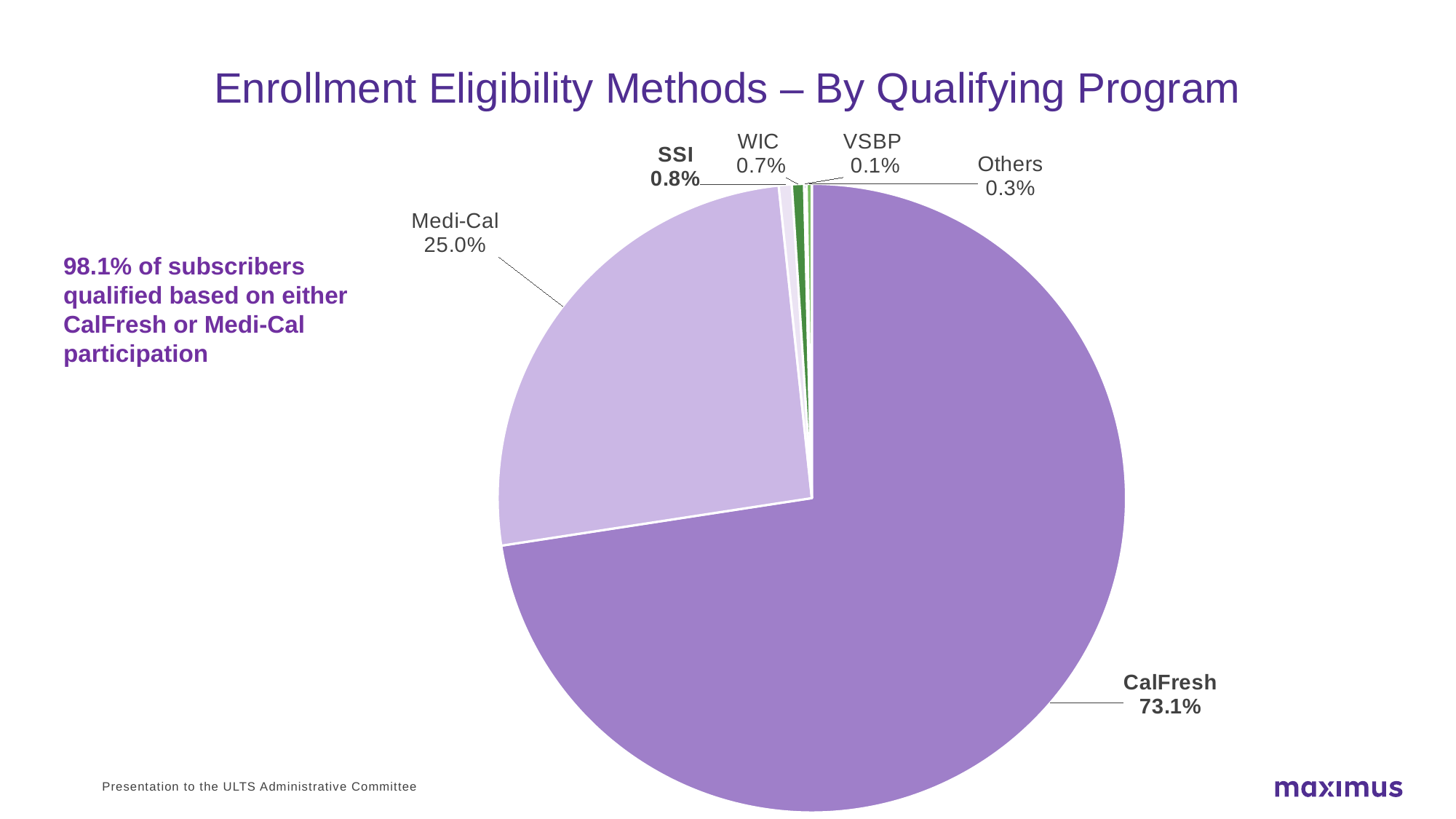
Which qualifying program has the smallest slice of the pie? VSBP What share of the pie does CalFresh represent? 73.1% How many slices does the pie chart have? 6 What is the difference between the CalFresh and Medi-Cal percentages? 48.1% What is the value shown for Others? 0.3% What is the value shown for Medi-Cal? 25.0% What is the value shown for VSBP? 0.1% What is the value shown for WIC? 0.7% What kind of chart is shown on the slide? Pie chart Which qualifying program has the largest slice of the pie? CalFresh Which is larger, the share for SSI or the share for WIC? SSI What is the value shown for SSI? 0.8%